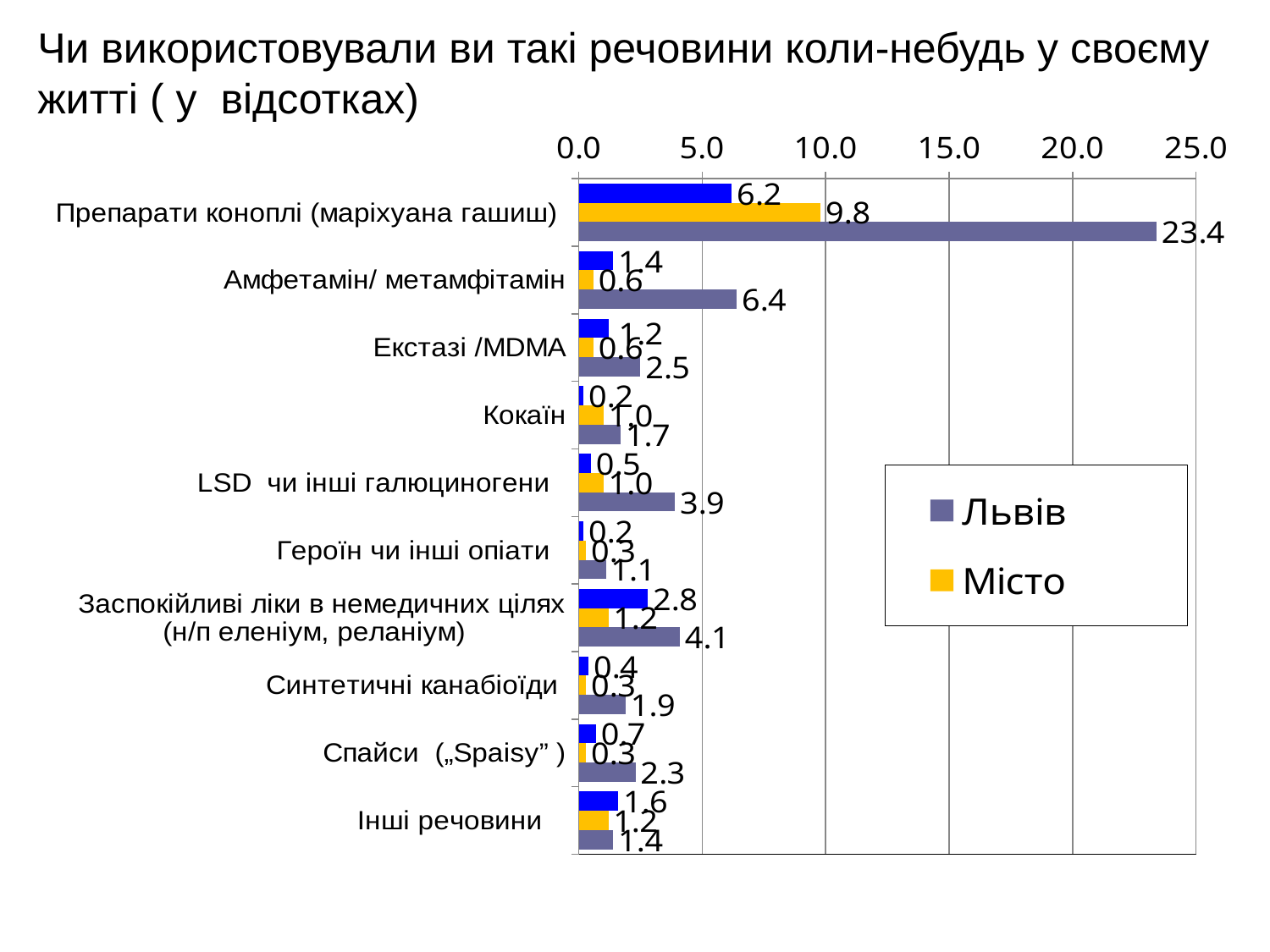
What is the Місто value for LSD чи інші галюциногени? 1.0 What is the Місто value for Препарати коноплі (маріхуана гашиш)? 9.8 How many substance categories are listed on the chart? 10 Which category has the lowest Львів value? Героїн чи інші опіати Which is larger for Заспокійливі ліки в немедичних цілях: the Львів value or the Місто value? Львів What is the difference between the Львів and Місто values for Препарати коноплі (маріхуана гашиш)? 13.6 Is the Львів value for Препарати коноплі (маріхуана гашиш) greater or less than 20.0? greater How many series does the legend list? 2 What kind of chart is shown on the slide? bar chart Which category has the highest Львів value? Препарати коноплі (маріхуана гашиш) What is the Львів value for Амфетамін/ метамфітамін? 6.4 What is the Львів value for Препарати коноплі (маріхуана гашиш)? 23.4